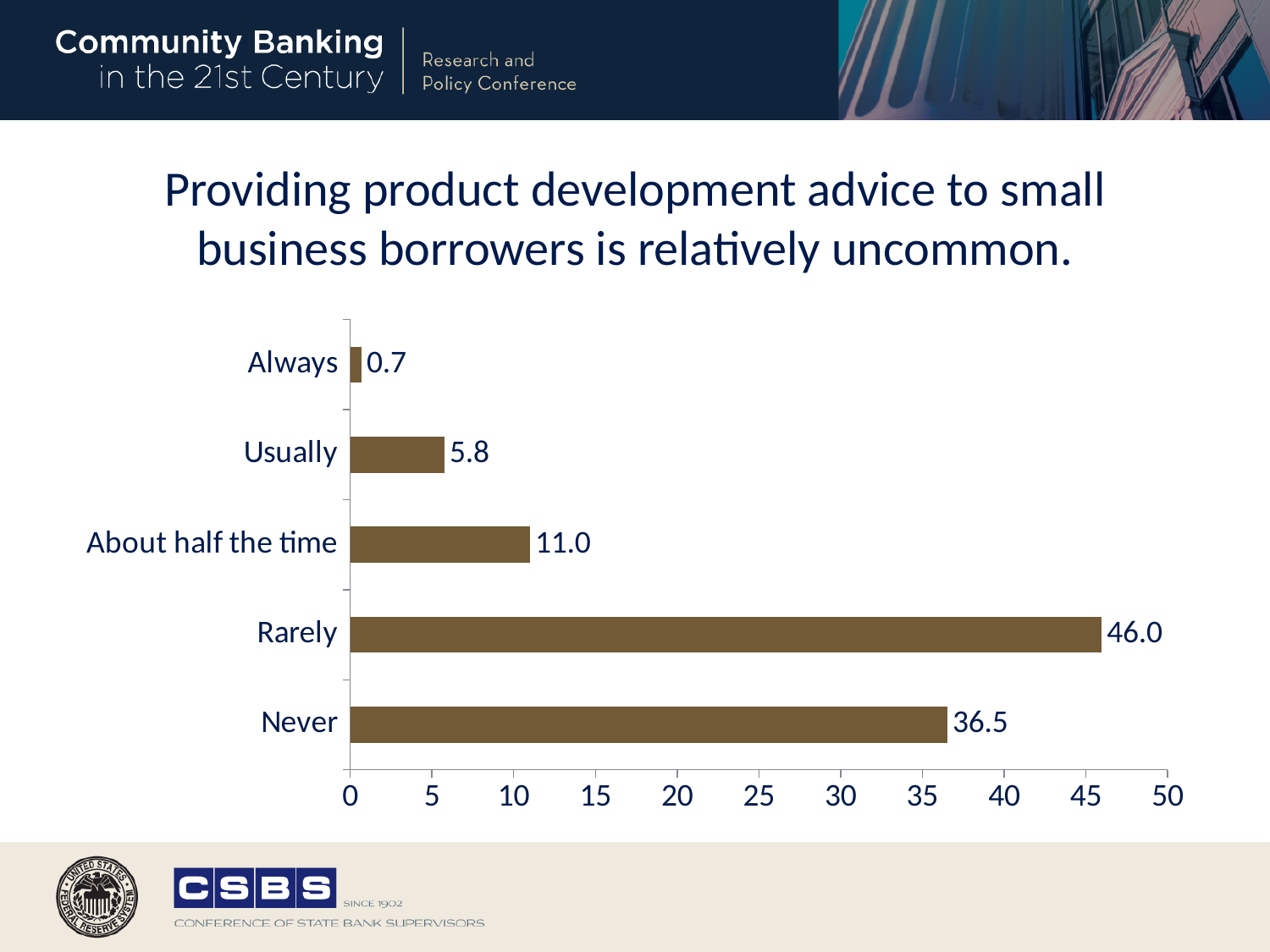
How many categories are shown in the chart? 5 What is the value for Usually? 5.8 What is the value for Rarely? 46.0 What kind of chart is shown on the slide? bar chart Which category has the highest value? Rarely What is the value for About half the time? 11.0 Which category has the lowest value? Always What is the difference between the values for Rarely and Never? 9.5 Is the value for Never greater or less than 40? less What is the value for Never? 36.5 Which is larger, the value for Usually or the value for About half the time? About half the time What is the value for Always? 0.7